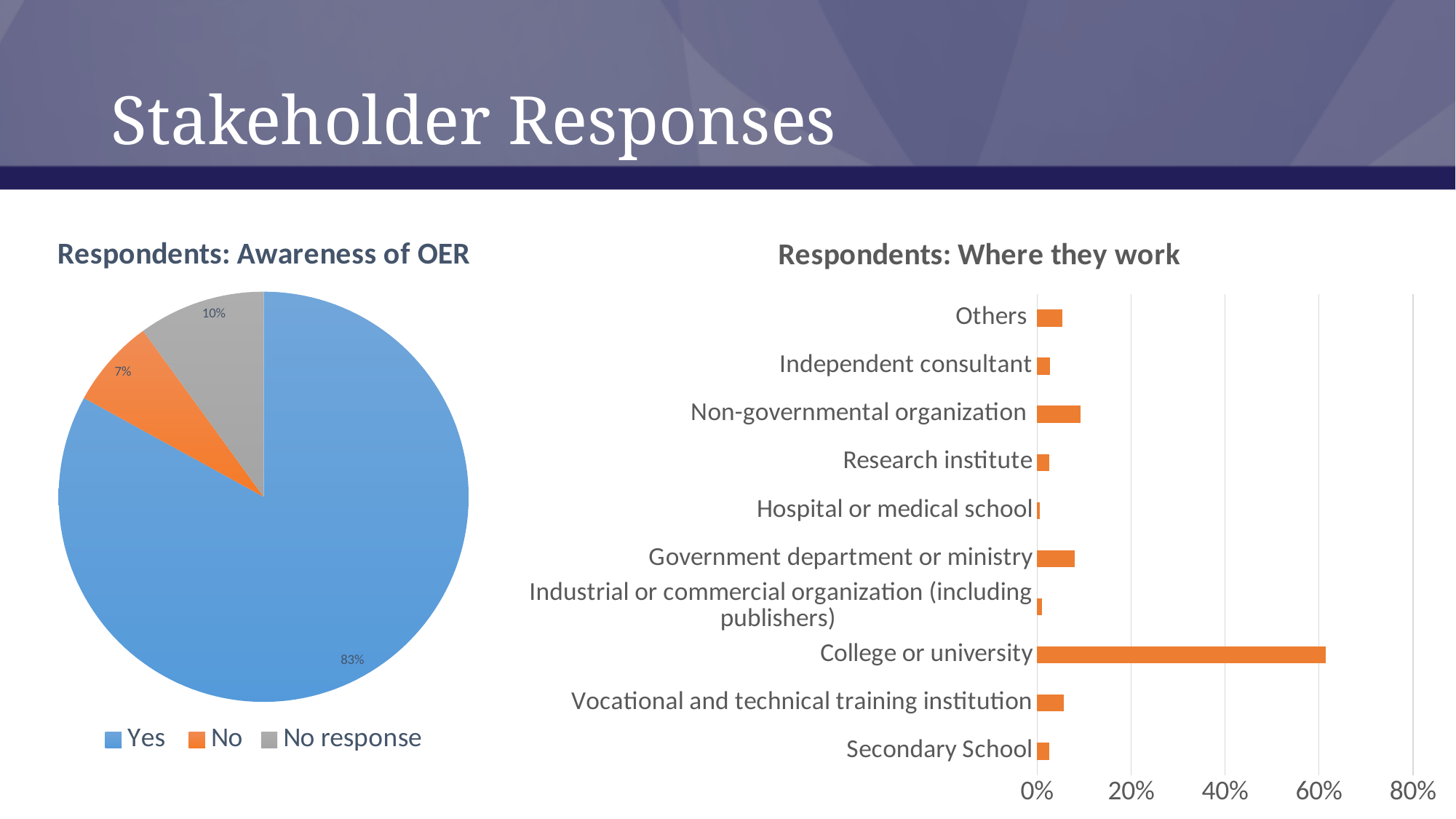
In the 'Respondents: Awareness of OER' chart, what is the difference between the Yes share and the No response share? 73% What kind of chart is 'Respondents: Where they work'? Bar chart In the 'Respondents: Where they work' chart, is the value for Non-governmental organization greater or less than 20%? less In the 'Respondents: Awareness of OER' chart, what percentage of respondents answered Yes? 83% In the 'Respondents: Awareness of OER' chart, what percentage of respondents answered No? 7% What kind of chart is 'Respondents: Awareness of OER'? Pie chart In the 'Respondents: Awareness of OER' chart, which category has the smallest share? No In the 'Respondents: Where they work' chart, which category has the highest value? College or university How many categories are shown in the 'Respondents: Where they work' chart? 10 How many entries does the legend of the 'Respondents: Awareness of OER' chart list? 3 In the 'Respondents: Where they work' chart, is the value for College or university greater or less than 40%? greater In the 'Respondents: Awareness of OER' chart, what percentage gave no response? 10%